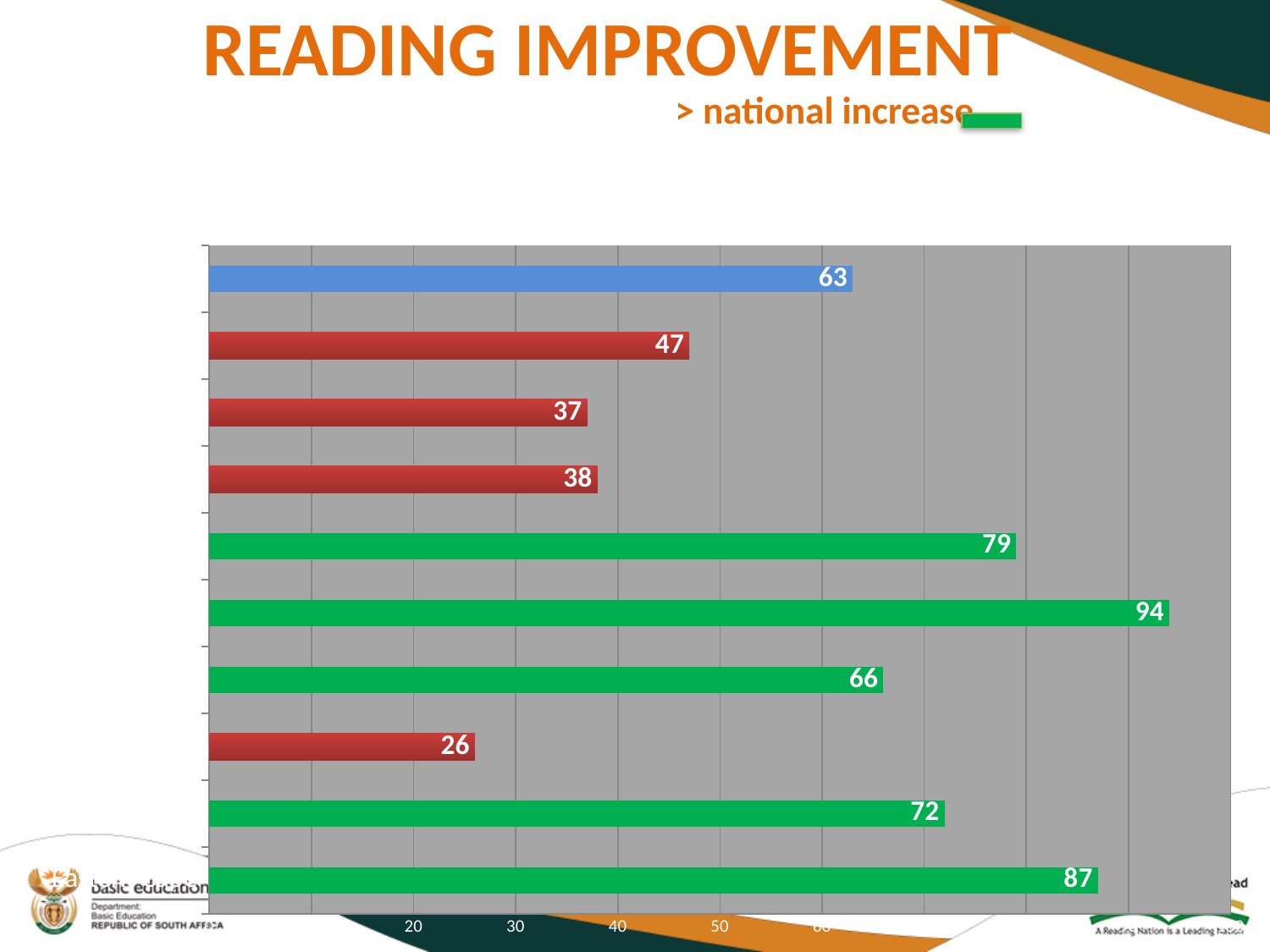
What is the title of the chart slide? READING IMPROVEMENT Which is larger: the second bar from the top (47) or the third bar from the top (37)? 47 What is the difference between the highest value (94) and the lowest value (26) in the chart? 68 What kind of chart is shown on the slide? bar chart What is the value of the topmost (blue) bar in the chart? 63 How many bars are plotted in the chart? 10 Is the value of the bar labelled 26 greater or less than 30? less What is the lowest value shown in the chart? 26 What is the difference between the topmost bar (63) and the bottom bar (87)? 24 What is the highest value shown in the chart? 94 What is the value of the bottom bar in the chart? 87 What colour is the topmost bar in the chart? blue